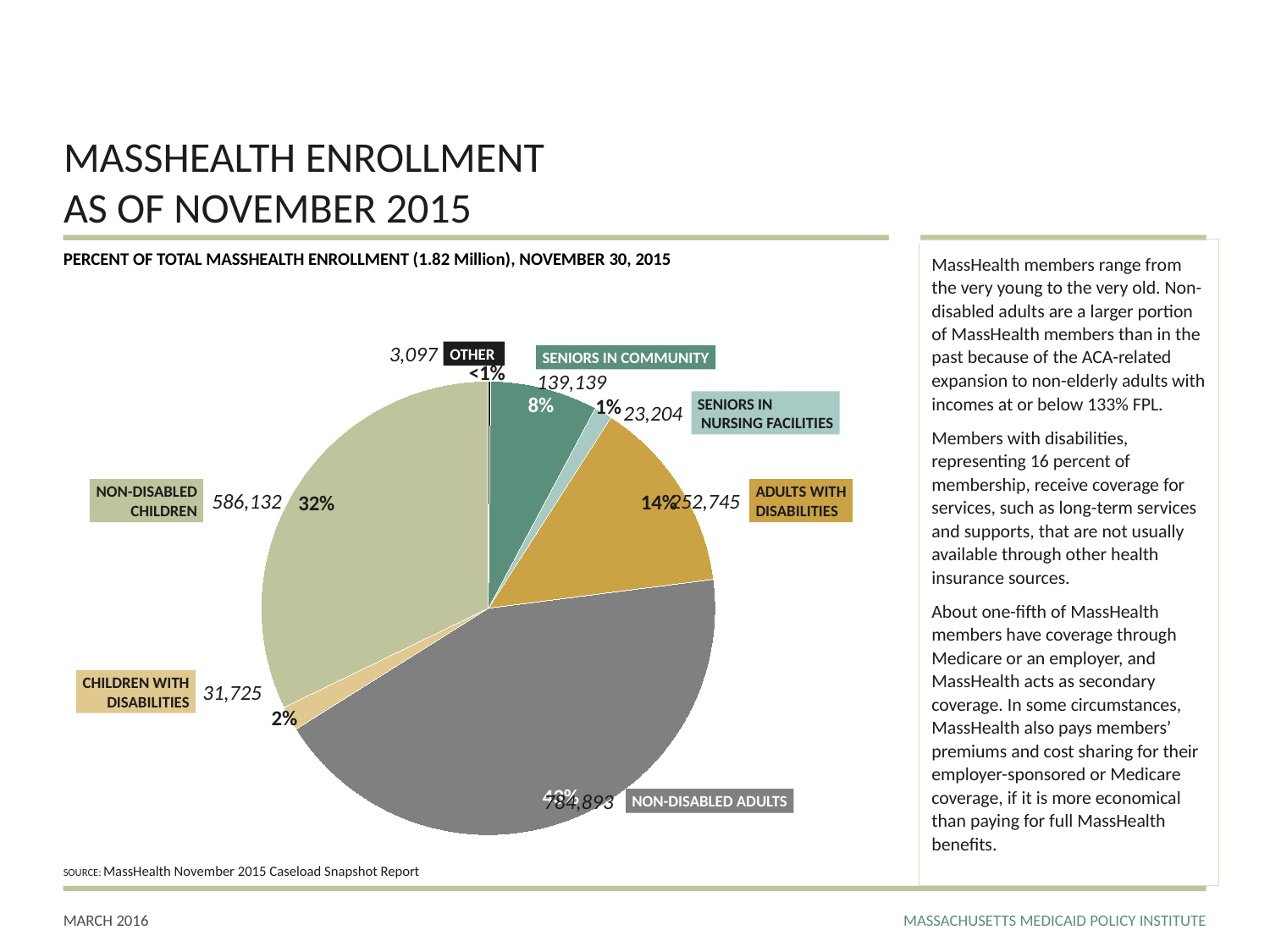
What percent of total MassHealth enrollment is Adults with Disabilities? 14% How many members are in the Seniors in Nursing Facilities category? 23,204 How many enrollment categories are shown in the pie chart? 7 What share of the pie does Non-Disabled Children represent? 32% Which category has the smallest share of MassHealth enrollment? Other What is the difference in members between Adults with Disabilities and Seniors in Community? 113,606 What percent of enrollment does the Other category represent? <1% Which category has more members: Seniors in Community or Seniors in Nursing Facilities? Seniors in Community How many more members are in Non-Disabled Children than in Children with Disabilities? 554,407 Which category has the largest share of MassHealth enrollment? Non-Disabled Adults How many members are in the Non-Disabled Children category? 586,132 What kind of chart is shown on the slide? pie chart